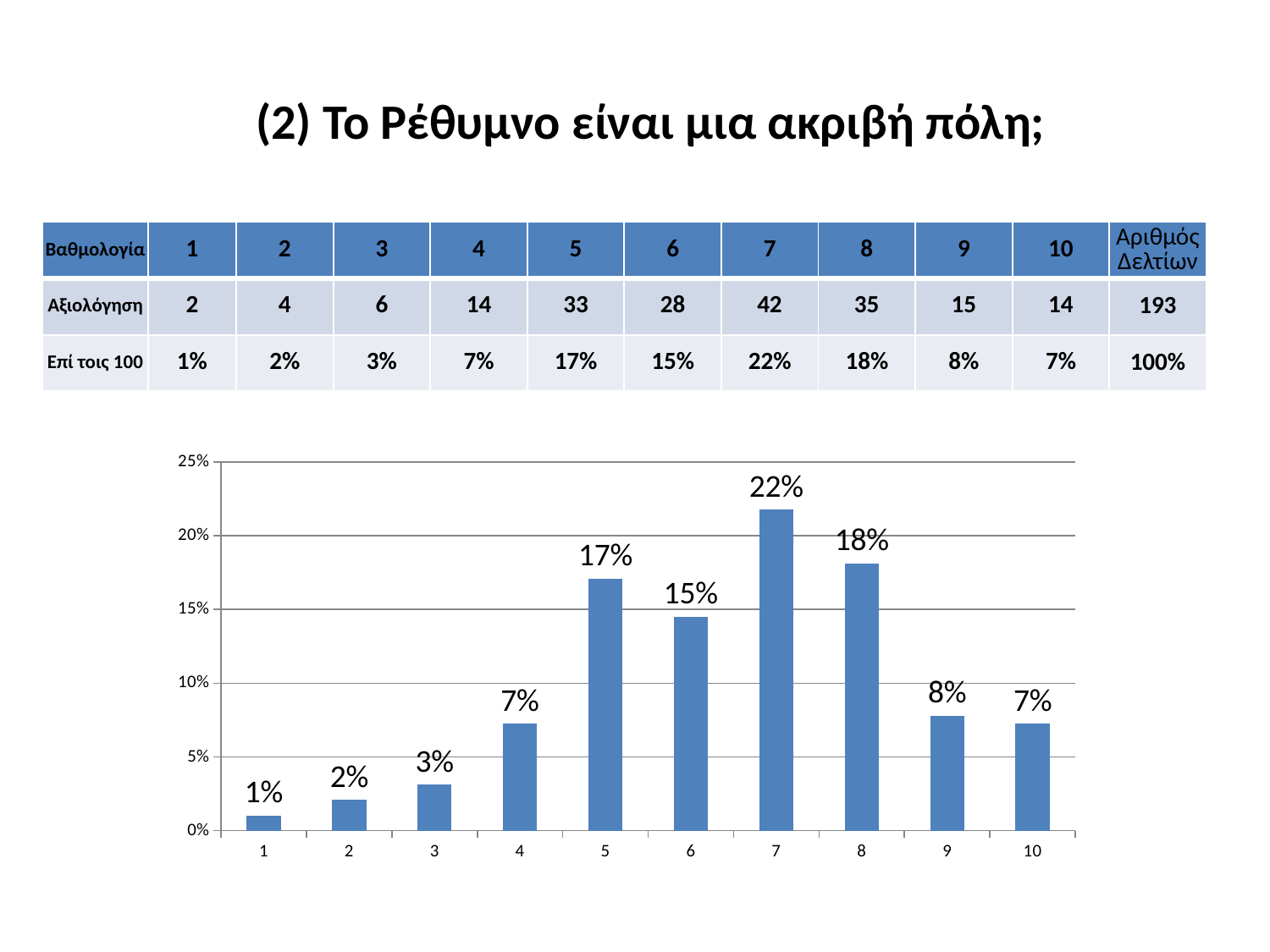
What is the difference between the values for category 5 and category 6? 2% Do the values rise or fall from category 1 to category 7? rise overall, though category 6 dips below category 5 What is the difference between the values for category 7 and category 8? 4% What kind of chart is shown on the slide? bar chart Which category has the highest value? 7 What is the value for category 1? 1% Is the value for category 7 greater or less than 20%? greater How many categories (bars) does the chart have? 10 Which is larger, the value for category 6 or the value for category 8? category 8 What is the value for category 5? 17% Which category has the lowest value? 1 What is the value for category 7? 22%